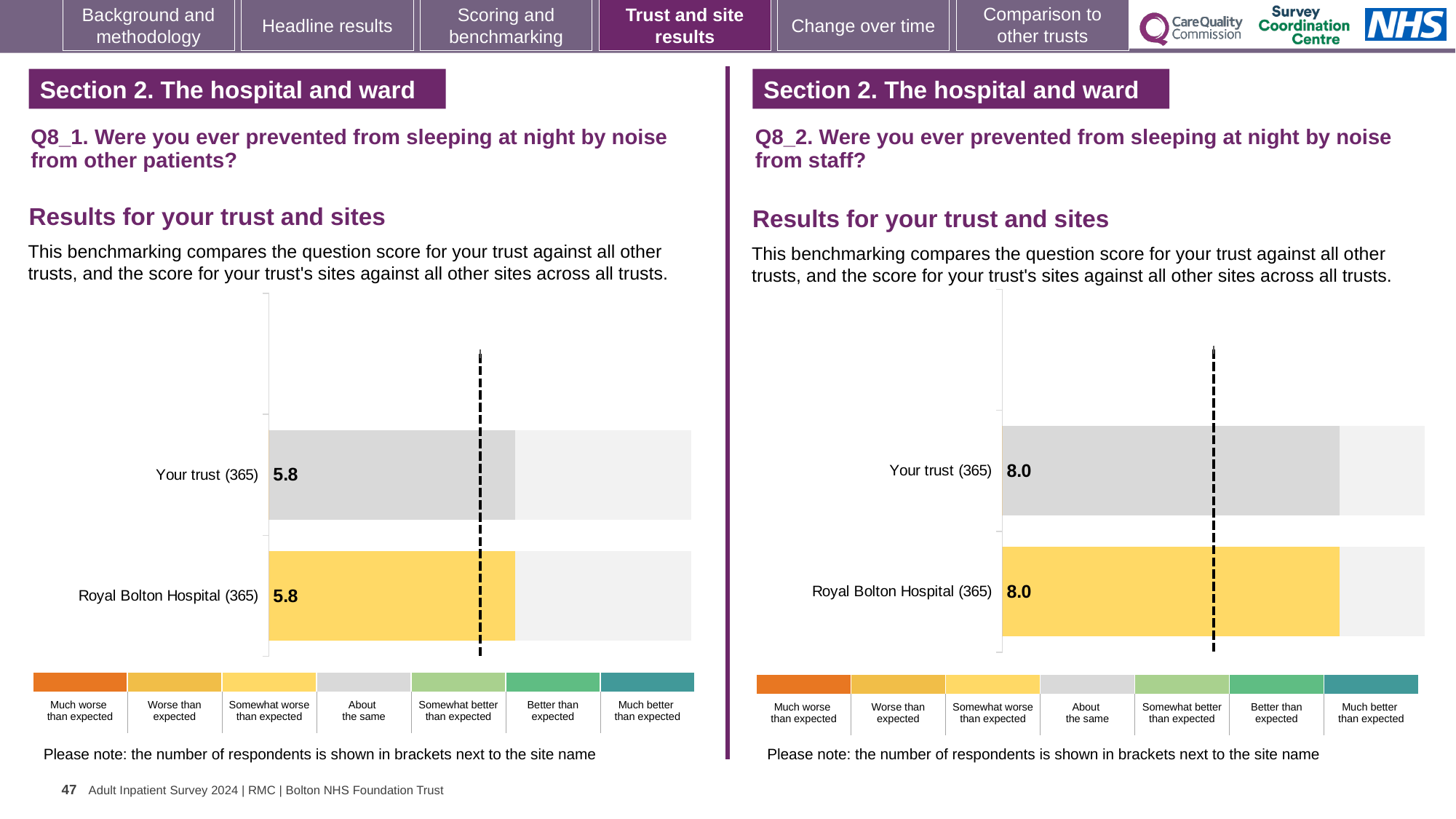
Is the Your trust score on the right chart (Q8_2) larger or smaller than the Your trust score on the left chart (Q8_1)? larger On the left chart (Q8_1, noise from other patients), what is the score for Your trust (365)? 5.8 On the left chart (Q8_1), what colour is the bar for Royal Bolton Hospital (365)? yellow On the left chart (Q8_1, noise from other patients), what is the score for Royal Bolton Hospital (365)? 5.8 On the right chart (Q8_2, noise from staff), what is the score for Your trust (365)? 8.0 How many bars are plotted on the right chart (Q8_2)? 2 What is the difference between the Royal Bolton Hospital score on the right chart (Q8_2) and the Royal Bolton Hospital score on the left chart (Q8_1)? 2.2 On the right chart (Q8_2, noise from staff), what is the score for Royal Bolton Hospital (365)? 8.0 How many bars are plotted on the left chart (Q8_1)? 2 On the left chart (Q8_1), what is the difference between the score for Your trust and the score for Royal Bolton Hospital? 0.0 What kind of chart is used on the left (Q8_1) to show the results for your trust and sites? bar chart How many respondents are shown in brackets next to Royal Bolton Hospital on the right chart (Q8_2)? 365